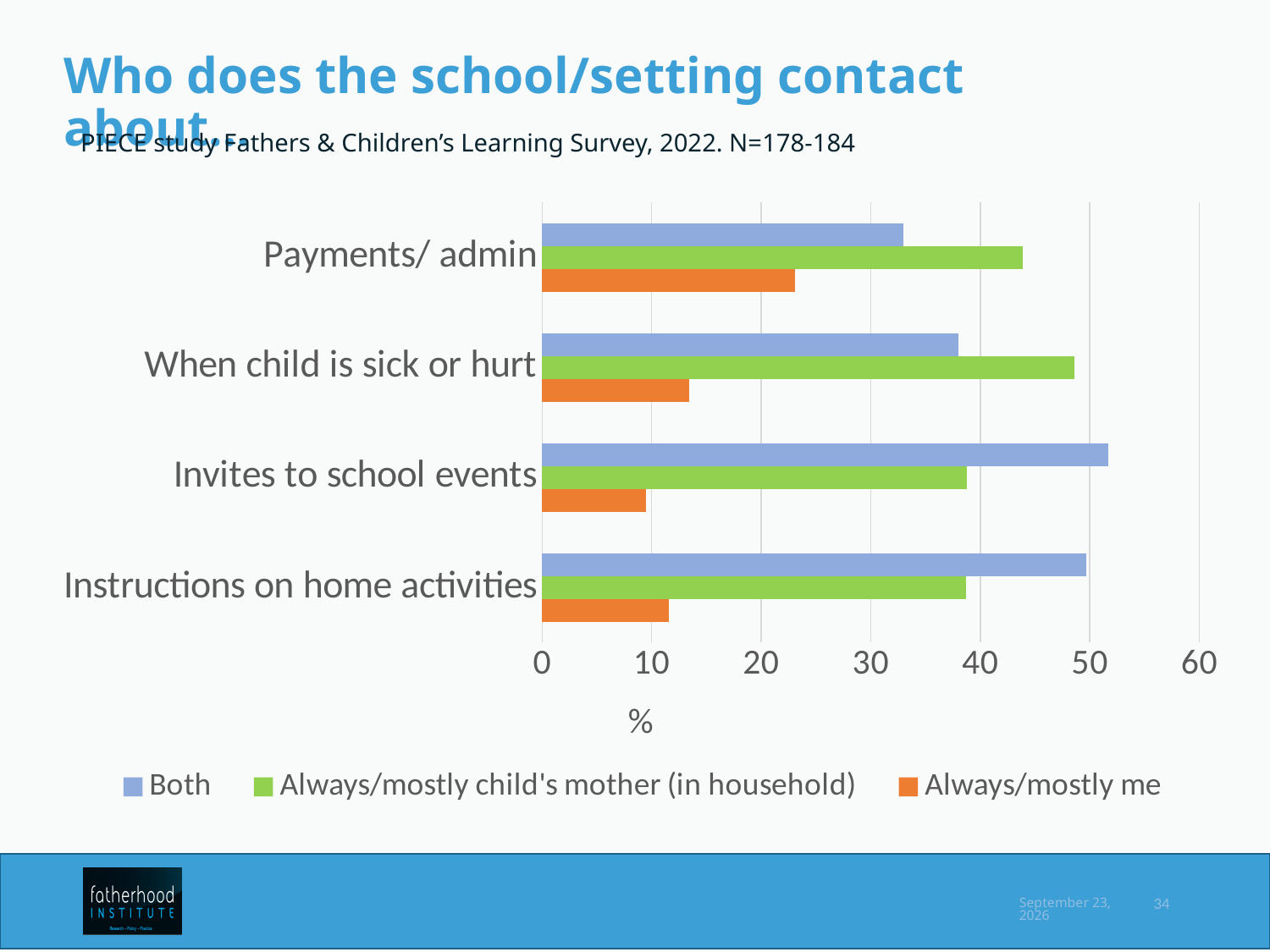
Which category has the highest value for 'Always/mostly child's mother (in household)'? When child is sick or hurt Is the value for 'Both' for 'Payments/ admin' greater or less than 40? less For 'Payments/ admin', which is larger: 'Both' or 'Always/mostly child's mother (in household)'? Always/mostly child's mother (in household) What is the label on the horizontal axis of the chart? % How many categories are shown on the chart? 4 Which category has the highest value for 'Always/mostly me'? Payments/ admin Which category has the lowest value for 'Both'? Payments/ admin How many series does the legend list? 3 Is the value for 'Both' for 'Invites to school events' greater or less than 40? greater Is the value for 'Always/mostly me' for 'Invites to school events' greater or less than 20? less What kind of chart is shown on the slide? bar chart